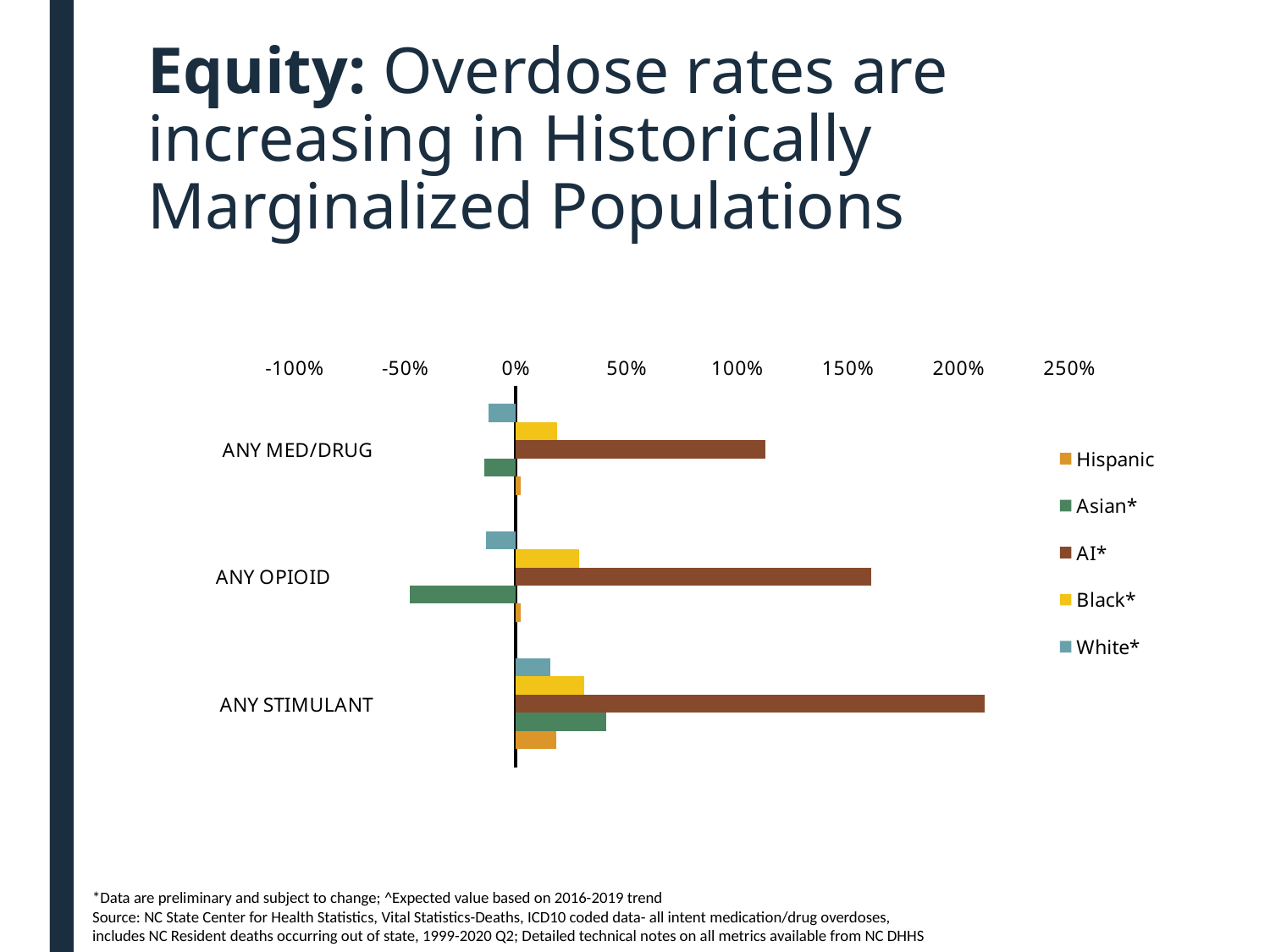
Is the AI* value for ANY OPIOID greater or less than 150%? greater Which series has the lowest value in the ANY OPIOID category? Asian* How many series does the chart's legend list? 5 How many categories are shown on the chart's vertical axis? 3 What kind of chart is shown on the slide? bar chart Is the AI* value for ANY MED/DRUG greater or less than 100%? greater Is the AI* value for ANY STIMULANT greater or less than 200%? greater Which category has the highest AI* value? ANY STIMULANT Which is larger: the AI* value for ANY STIMULANT or the AI* value for ANY OPIOID? ANY STIMULANT Which series has the highest value in the ANY STIMULANT category? AI* Which series is shown in brown in the chart's legend? AI*